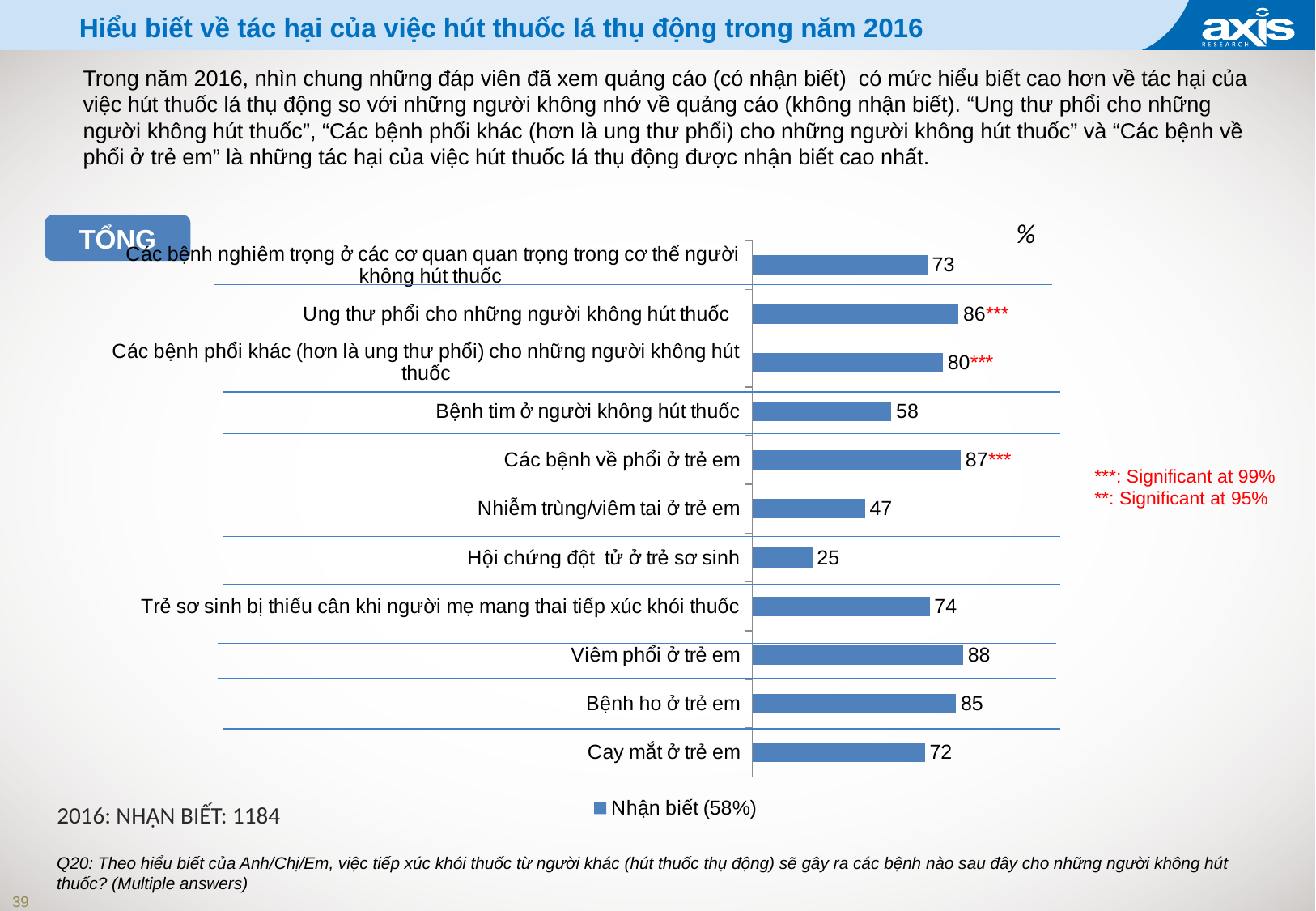
What value is shown for "Cay mắt ở trẻ em"? 72 Which category has the highest value in the chart? Viêm phổi ở trẻ em Which is larger: the value for "Bệnh ho ở trẻ em" or the value for "Trẻ sơ sinh bị thiếu cân khi người mẹ mang thai tiếp xúc khói thuốc"? Bệnh ho ở trẻ em What value is shown for "Hội chứng đột tử ở trẻ sơ sinh"? 25 What is the legend entry for the series in the chart? Nhận biết (58%) What is the difference between the values for "Các bệnh về phổi ở trẻ em" and "Nhiễm trùng/viêm tai ở trẻ em"? 40 What value is shown for "Ung thư phổi cho những người không hút thuốc"? 86 What value is shown for "Bệnh tim ở người không hút thuốc"? 58 How many categories are plotted in the chart? 11 How many series does the legend list? 1 What kind of chart is shown on the slide? Bar chart Which category has the lowest value in the chart? Hội chứng đột tử ở trẻ sơ sinh